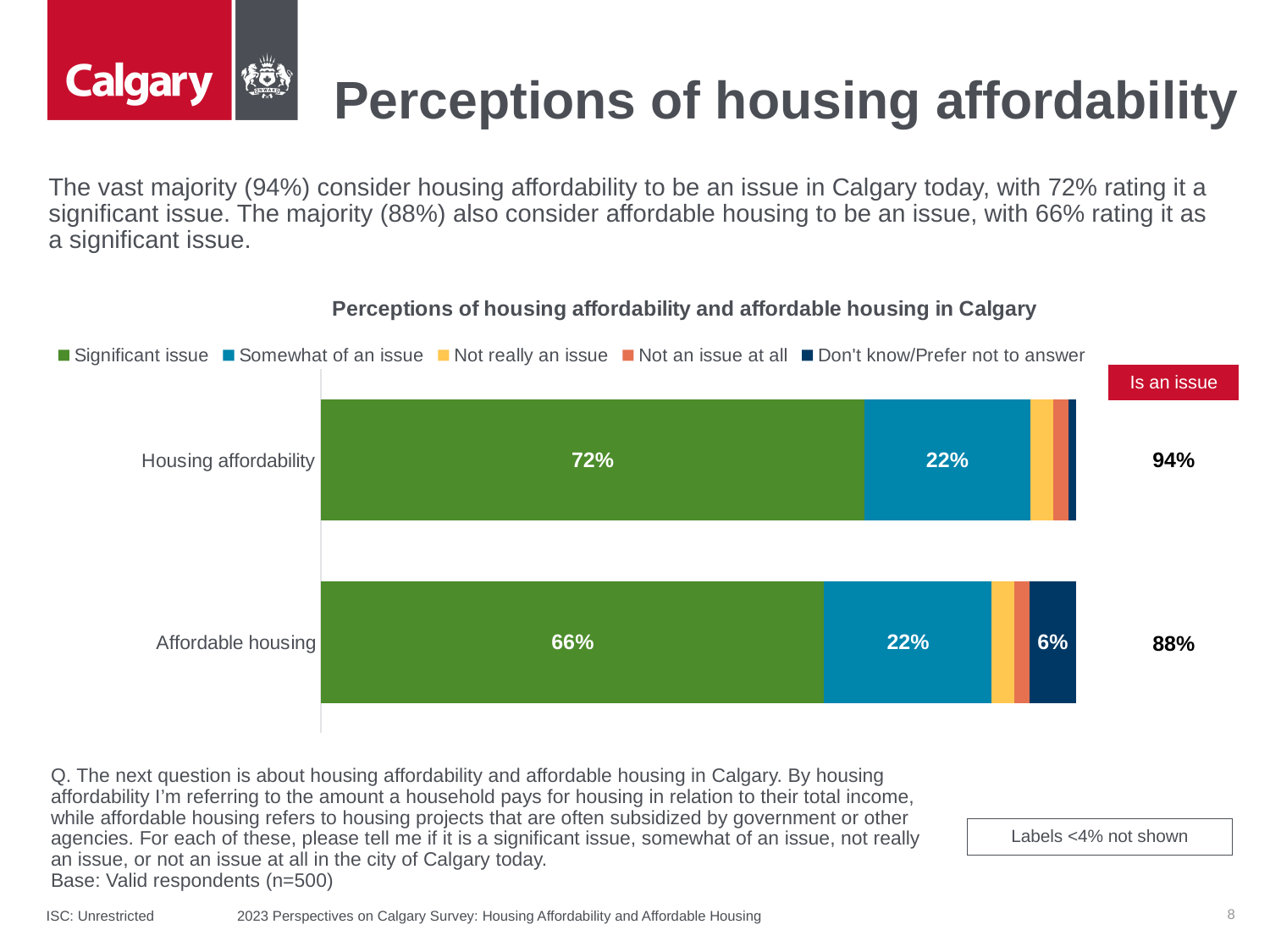
What is the difference between the 'Is an issue' percentages for housing affordability and affordable housing? 6% Which category has the higher share of respondents rating it a significant issue, housing affordability or affordable housing? Housing affordability What percentage of respondents rate affordable housing as a significant issue? 66% What percentage of respondents rate housing affordability as a significant issue? 72% According to the 'Is an issue' column, what percentage consider housing affordability to be an issue? 94% What type of chart is shown on the slide? Stacked bar chart How many categories are shown on the chart? 2 According to the 'Is an issue' column, what percentage consider affordable housing to be an issue? 88% What is the difference between the 'Significant issue' percentages for housing affordability and affordable housing? 6% What percentage of respondents answered 'Don't know/Prefer not to answer' for affordable housing? 6% What percentage of respondents consider affordable housing to be somewhat of an issue? 22% How many series does the legend list? 5